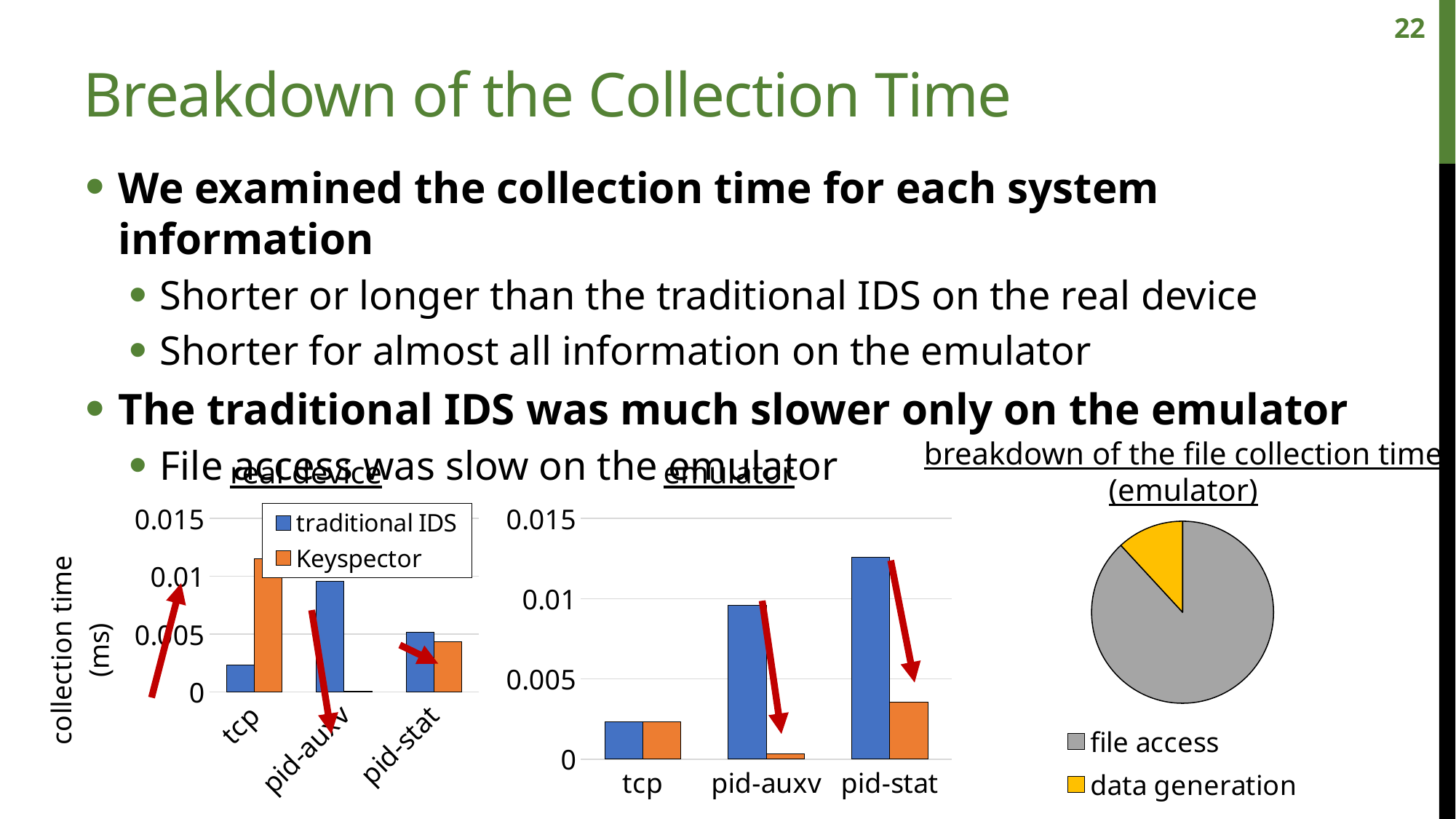
In the 'real device' chart, is the Keyspector value for tcp greater or less than 0.01? greater In the 'real device' chart, how many categories are shown on the x axis? 3 In the 'real device' chart, how many series does the legend list? 2 In the 'emulator' chart, which series has the larger value for pid-stat, traditional IDS or Keyspector? traditional IDS What kind of chart is the 'real device' chart? bar chart How many slices does the pie chart 'breakdown of the file collection time (emulator)' have? 2 In the pie chart 'breakdown of the file collection time (emulator)', which slice is the largest? file access In the 'emulator' chart, is the traditional IDS value for pid-stat greater or less than 0.01? greater In the 'emulator' chart, is the Keyspector value for pid-auxv greater or less than 0.005? less In the 'emulator' chart, which category has the highest traditional IDS value? pid-stat In the 'real device' chart, which series has the larger value for tcp, traditional IDS or Keyspector? Keyspector